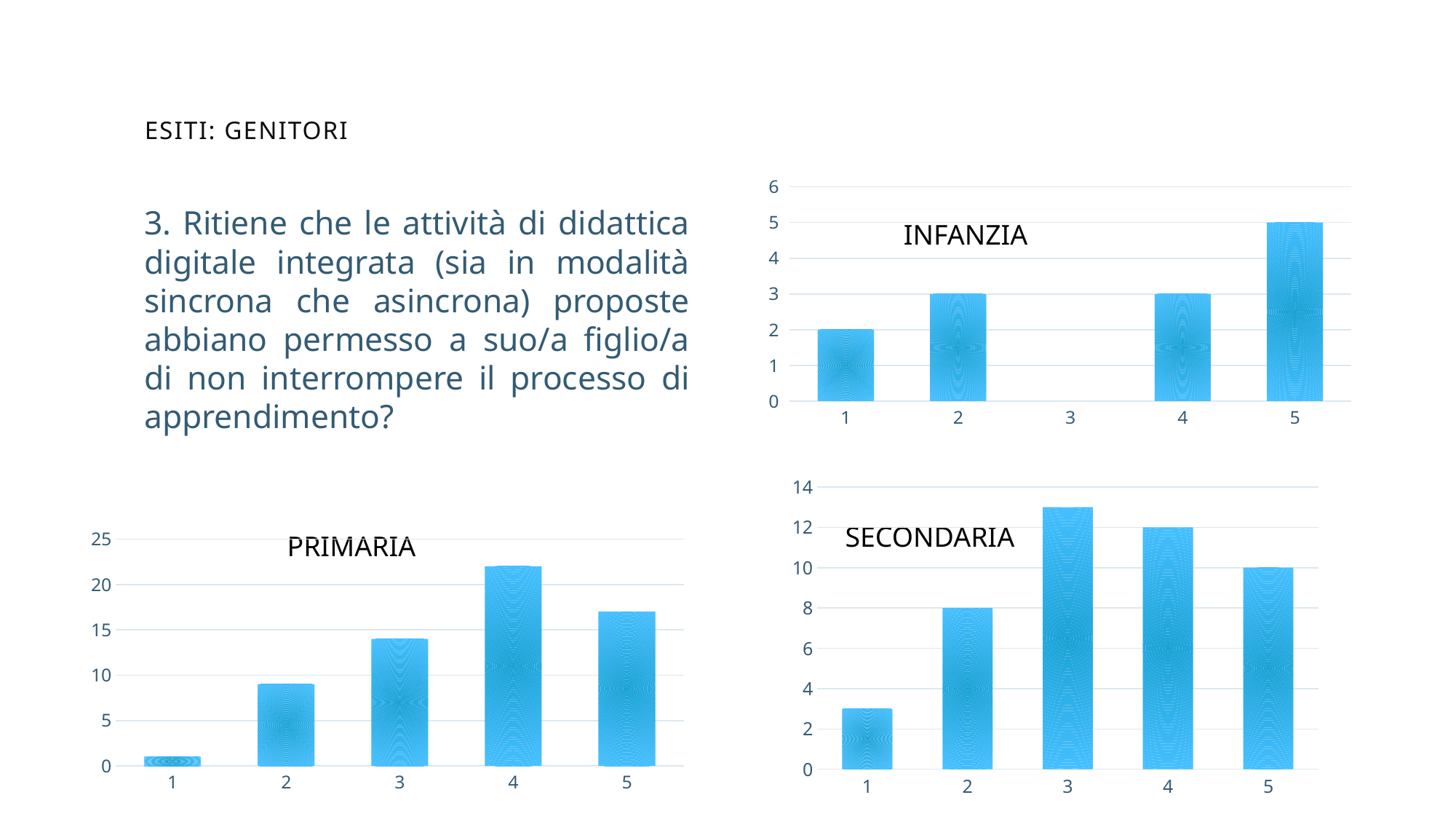
In the PRIMARIA chart, which category has the highest value? 4 In the SECONDARIA chart, what is the value for category 2? 8 In the INFANZIA chart, what is the value for category 1? 2 In the PRIMARIA chart, which category has the lowest value? 1 In the INFANZIA chart, what is the difference between the values for category 5 and category 2? 3 In the INFANZIA chart, which category has the highest value? 5 What kind of chart is the SECONDARIA chart? bar chart In the SECONDARIA chart, which category has the highest value? 3 In the PRIMARIA chart, is the value for category 2 greater or less than 10? less In the PRIMARIA chart, is the value for category 4 greater or less than 20? greater In the INFANZIA chart, what is the value for category 5? 5 In the SECONDARIA chart, which is larger, the value for category 4 or category 5? 4